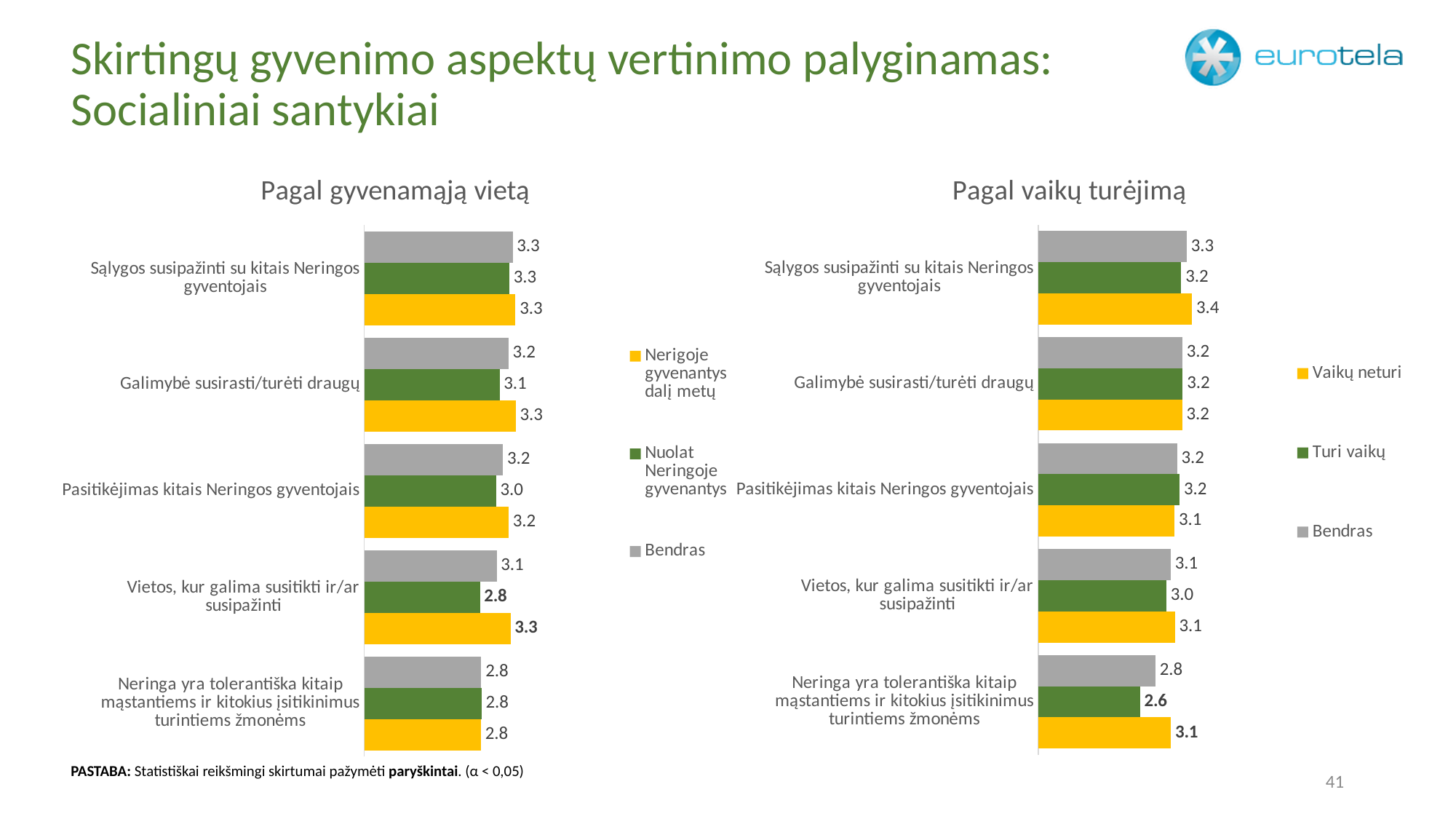
In the chart 'Pagal vaikų turėjimą', what is the value for 'Vaikų neturi' for 'Sąlygos susipažinti su kitais Neringos gyventojais'? 3.4 In the chart 'Pagal vaikų turėjimą', which category has the lowest value for 'Turi vaikų'? Neringa yra tolerantiška kitaip mąstantiems ir kitokius įsitikinimus turintiems žmonėms In the chart 'Pagal vaikų turėjimą', what is the value for 'Turi vaikų' for 'Neringa yra tolerantiška kitaip mąstantiems ir kitokius įsitikinimus turintiems žmonėms'? 2.6 In the chart 'Pagal gyvenamąją vietą', what is the difference between the 'Nerigoje gyvenantys dalį metų' and 'Nuolat Neringoje gyvenantys' values for 'Vietos, kur galima susitikti ir/ar susipažinti'? 0.5 In the chart 'Pagal vaikų turėjimą', what is the difference between the 'Vaikų neturi' and 'Turi vaikų' values for 'Neringa yra tolerantiška kitaip mąstantiems ir kitokius įsitikinimus turintiems žmonėms'? 0.5 What type of chart is 'Pagal vaikų turėjimą'? Bar chart In the chart 'Pagal gyvenamąją vietą', for 'Pasitikėjimas kitais Neringos gyventojais', which is larger: the 'Bendras' value or the 'Nuolat Neringoje gyvenantys' value? Bendras How many series does the legend of the chart 'Pagal gyvenamąją vietą' list? 3 How many categories are shown in the chart 'Pagal vaikų turėjimą'? 5 In the chart 'Pagal gyvenamąją vietą', what is the value for 'Nuolat Neringoje gyvenantys' for 'Vietos, kur galima susitikti ir/ar susipažinti'? 2.8 In the chart 'Pagal gyvenamąją vietą', what is the value for 'Nerigoje gyvenantys dalį metų' for 'Galimybė susirasti/turėti draugų'? 3.3 In the chart 'Pagal vaikų turėjimą', which colour represents the 'Vaikų neturi' series? Yellow